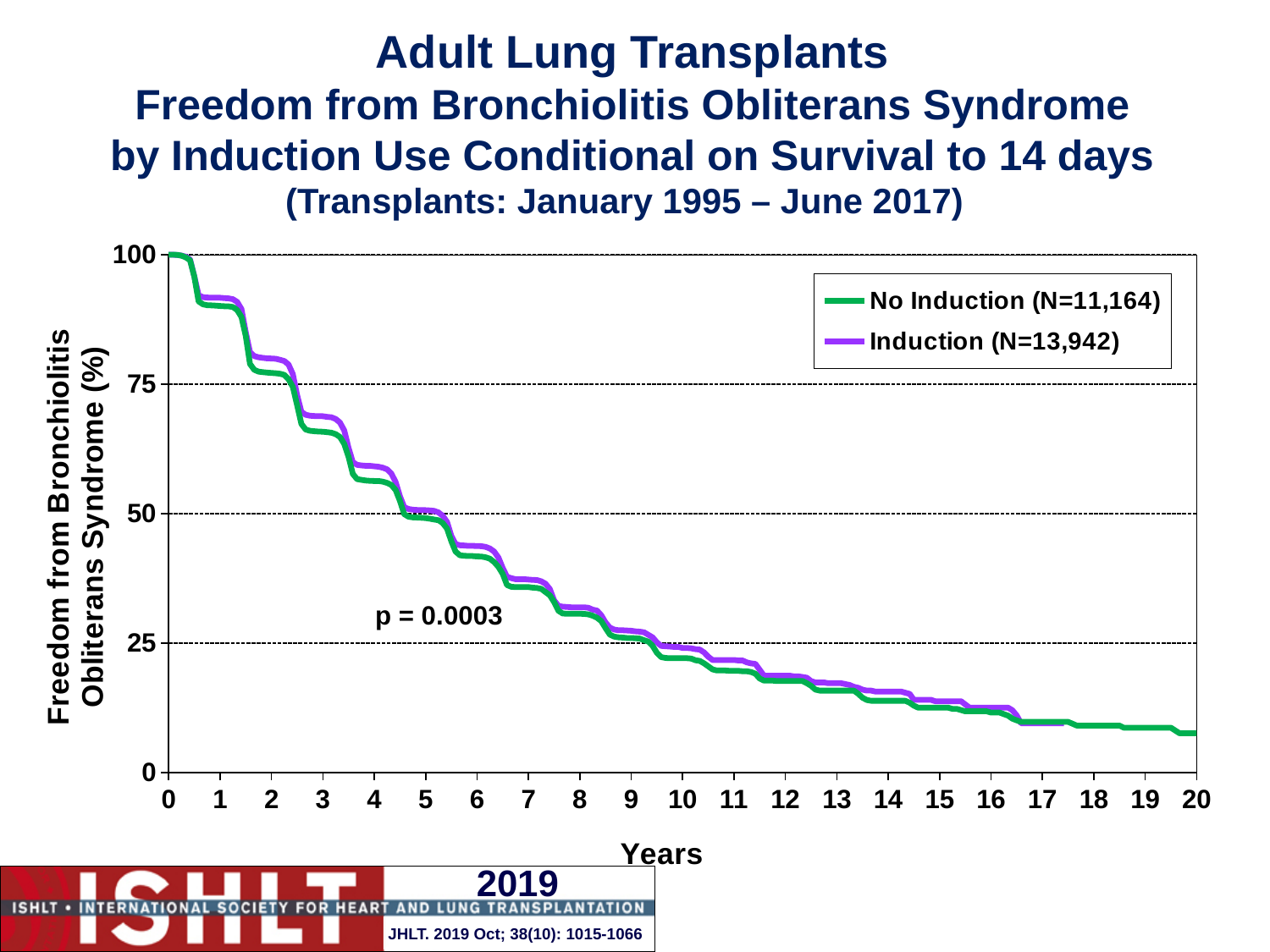
At 3 years, which series has the higher value, Induction or No Induction? Induction Do the values rise or fall as the years increase along the x axis? fall Is the value for Induction at 4 years greater or less than 50? greater What p-value is printed on the chart? p = 0.0003 What kind of chart is shown on the slide? line chart What is the highest value labelled on the x axis? 20 What is the N for the No Induction group shown in the legend? N=11,164 Is the value for No Induction at 15 years greater or less than 25? less Is the value for Induction at 2 years greater or less than 75? greater How many series does the legend list? 2